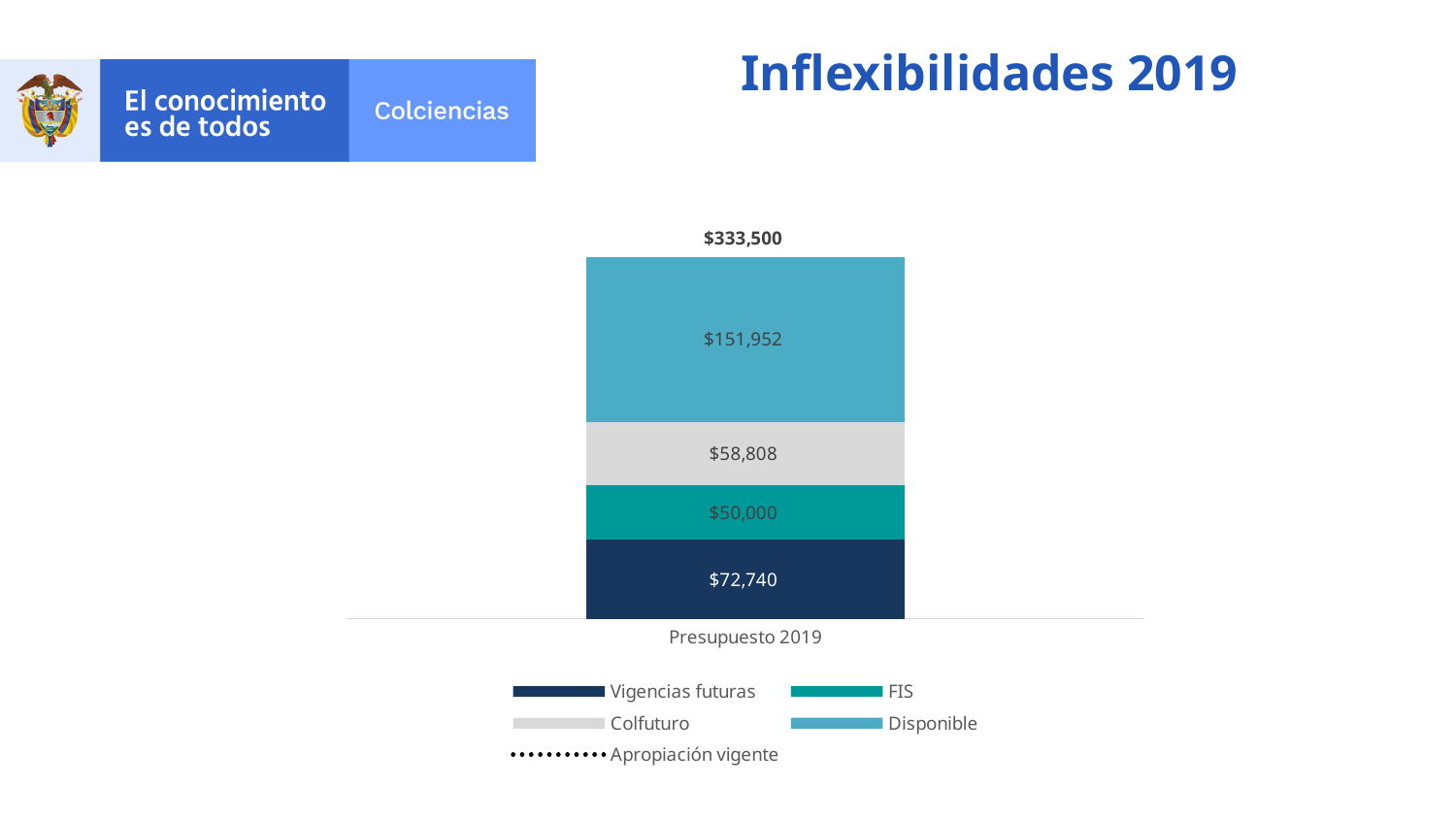
What kind of chart is shown on the slide? Stacked bar chart How many entries does the legend list? 5 What is the title of the slide containing the chart? Inflexibilidades 2019 Which is larger, the Colfuturo segment or the FIS segment? Colfuturo What is the total of the Presupuesto 2019 stacked bar? $333,500 What is the value of the FIS segment? $50,000 What is the difference between the Disponible and Vigencias futuras segments? $79,212 Which segment of the Presupuesto 2019 bar is the largest? Disponible What is the value of the Vigencias futuras segment? $72,740 Which segment of the Presupuesto 2019 bar is the smallest? FIS What is the value of the Disponible segment in the stacked bar? $151,952 What is the value of the Colfuturo segment? $58,808